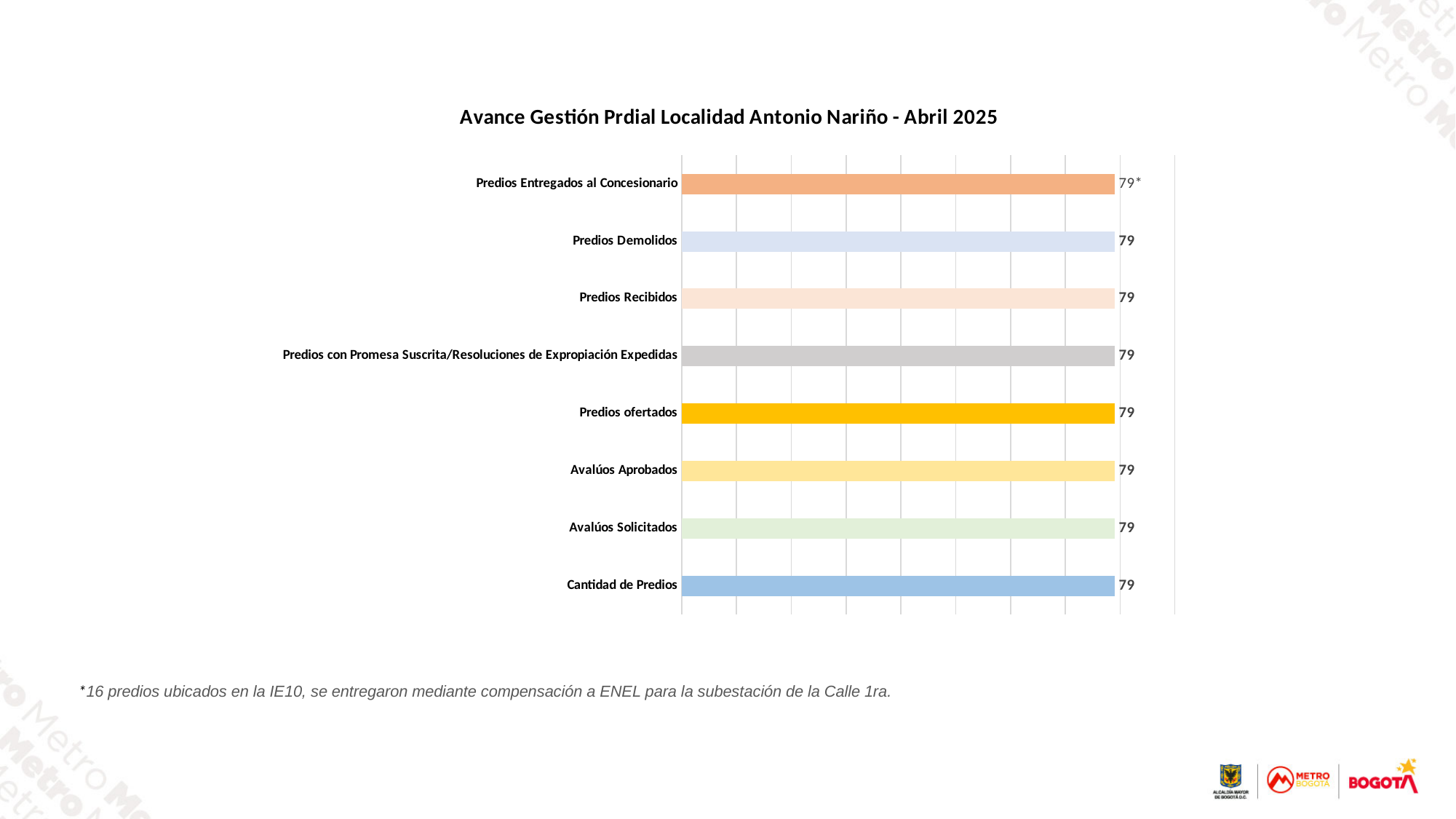
What is the value for Predios Demolidos? 79 Which category's data label is marked with an asterisk? Predios Entregados al Concesionario Do all the bars in the chart have the same value? Yes, all are 79 What is the value for Avalúos Solicitados? 79 What is the difference between the value for Predios ofertados and the value for Avalúos Aprobados? 0 What is the value for Predios con Promesa Suscrita/Resoluciones de Expropiación Expedidas? 79 What is the title of the chart? Avance Gestión Prdial Localidad Antonio Nariño - Abril 2025 What is the value for Cantidad de Predios? 79 What kind of chart is shown on the slide? Bar chart What is the value for Predios Entregados al Concesionario? 79 How many categories are shown in the chart? 8